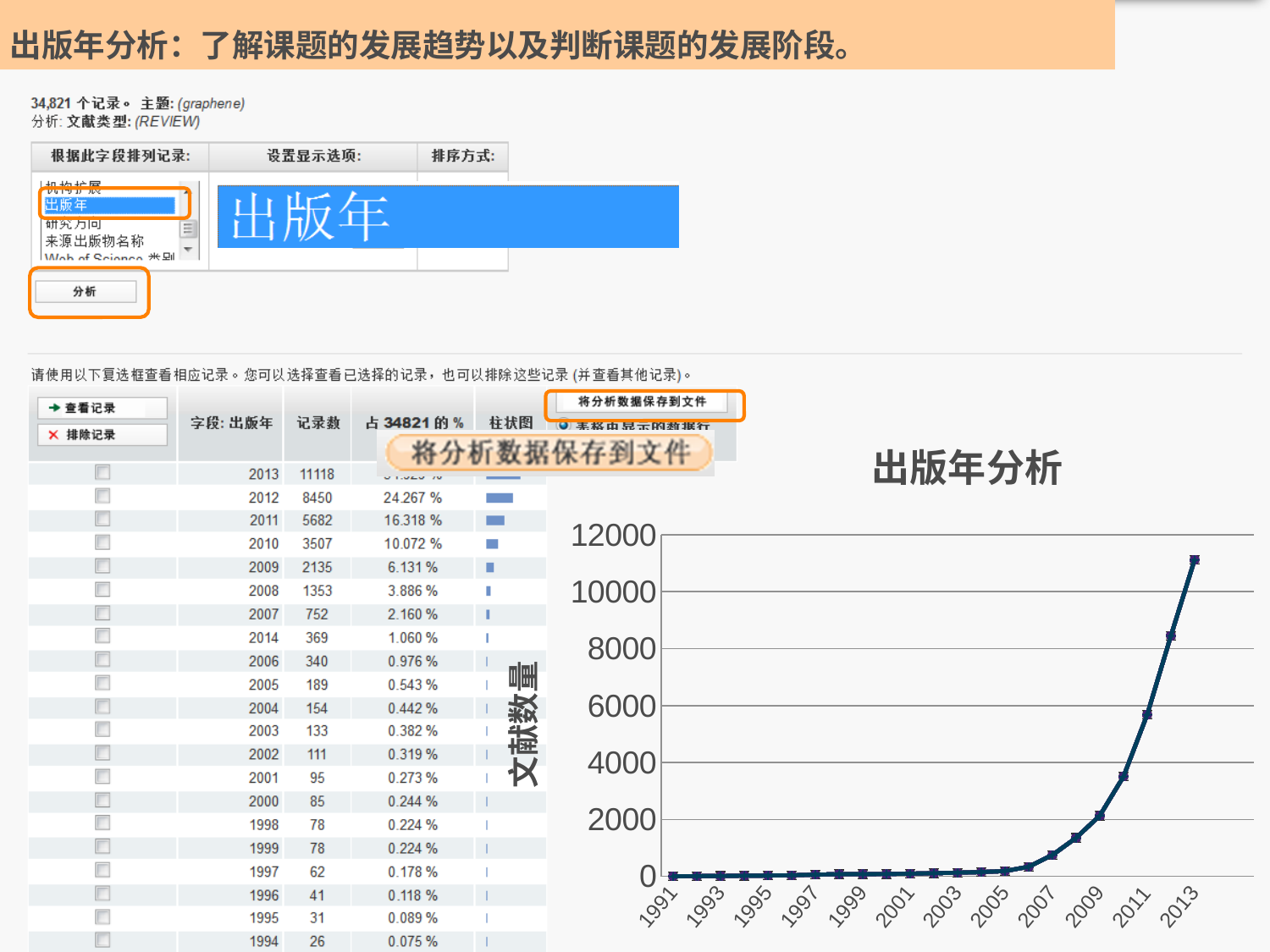
What kind of chart is the "出版年分析" chart? line chart How many year labels are shown on the x-axis of the "出版年分析" chart? 12 In the "出版年分析" chart, which year has the highest value? 2013 In the "出版年分析" chart, is the value for 2012 greater or less than 8000? greater In the "出版年分析" chart, do the values generally rise or fall from 1991 to 2013? rise In the "出版年分析" chart, is the value for 2013 larger than the value for 2011? yes What is the y-axis label of the "出版年分析" chart? 文献数量 In the "出版年分析" chart, is the value for 2013 greater or less than 10000? greater What is the title of the chart on the right side of the slide? 出版年分析 In the "出版年分析" chart, is the value for 2011 greater or less than 4000? greater